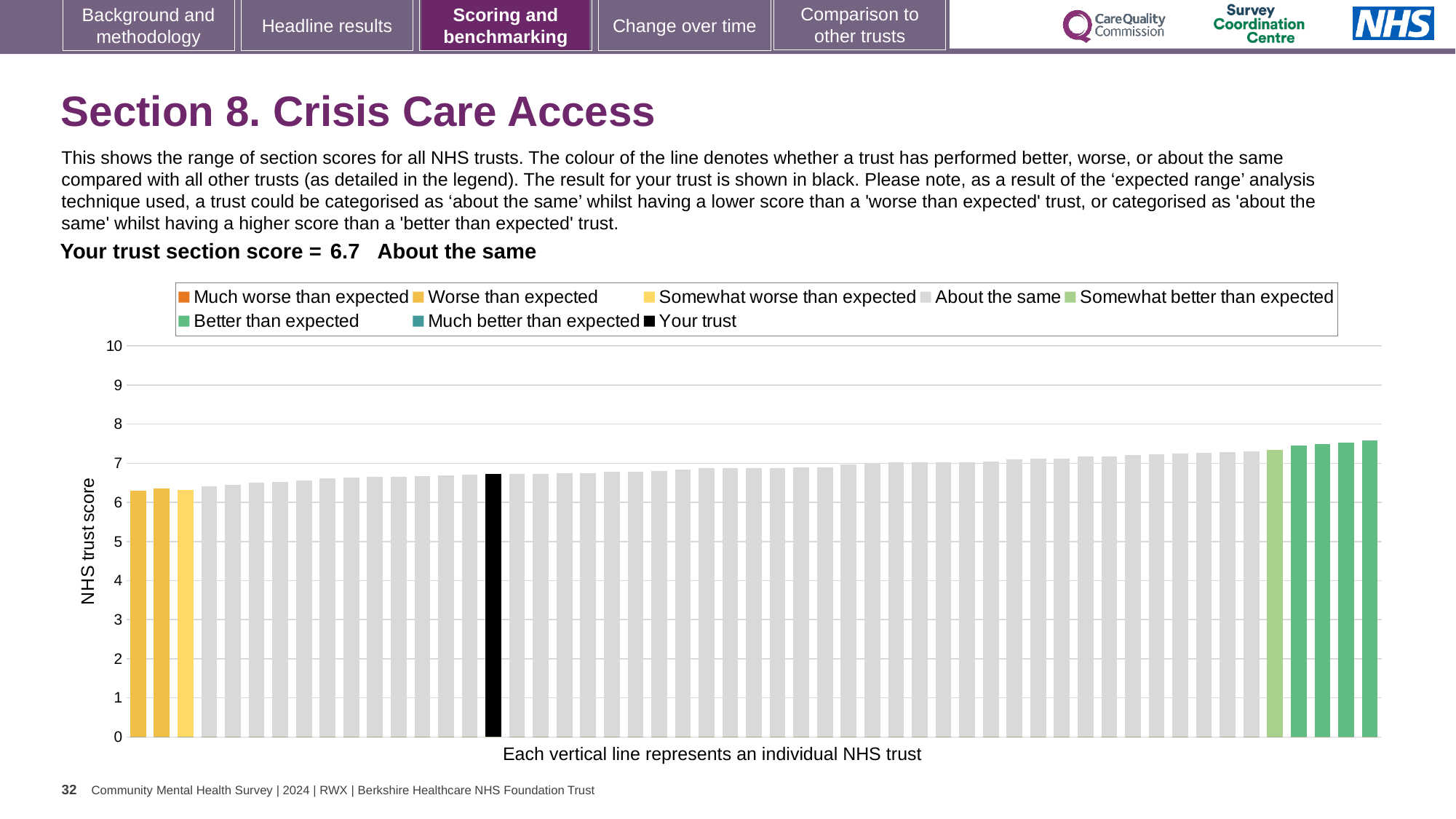
Is the value of the rightmost bar greater or less than 7? greater What kind of chart is shown on the slide? bar chart Which performance category is your trust placed in for Crisis Care Access? About the same How many bars are coloured as 'Worse than expected' (yellow)? 2 Do the bar values rise or fall from left to right across the chart? rise Which is larger: the score of your trust (black bar) or the score of the leftmost bar? your trust Is the value of the leftmost bar greater or less than 5? greater What is the section score for your trust shown on the slide? 6.7 How many entries does the chart legend list? 8 Is the value of the lowest bar greater or less than 7? less How many bars are coloured as 'Better than expected' (dark green)? 4 What is the label on the vertical axis of the chart? NHS trust score